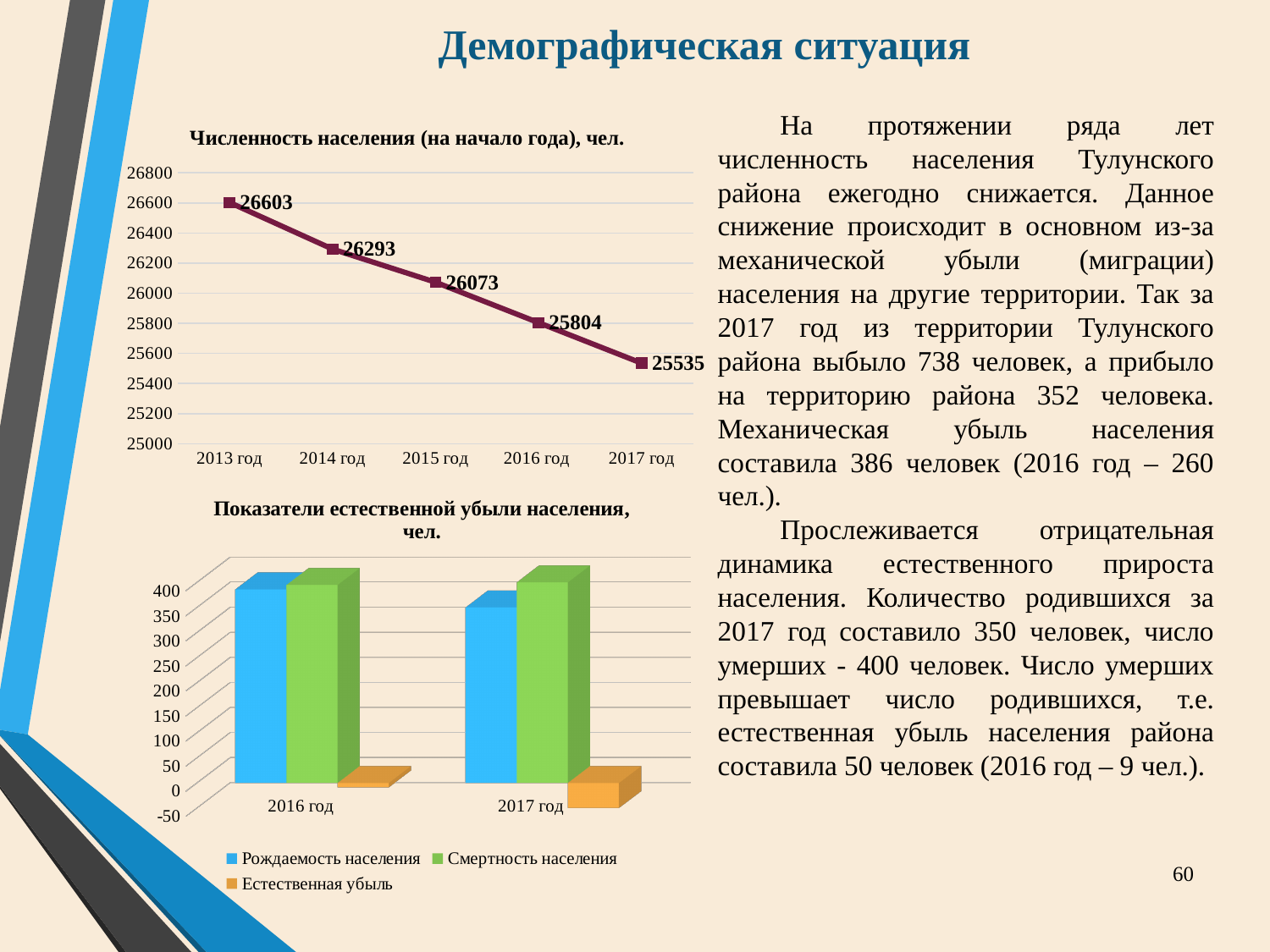
In the chart 'Численность населения (на начало года), чел.', what is the value for 2013 год? 26603 In the chart 'Показатели естественной убыли населения, чел.', how many series does the legend list? 3 In the chart 'Численность населения (на начало года), чел.', what is the difference between the values for 2013 год and 2017 год? 1068 In the chart 'Показатели естественной убыли населения, чел.', is the value for Рождаемость населения in 2017 год greater or less than 400? less In the chart 'Численность населения (на начало года), чел.', what is the value for 2015 год? 26073 In the chart 'Численность населения (на начало года), чел.', what is the value for 2017 год? 25535 In the chart 'Численность населения (на начало года), чел.', which year has the lowest value? 2017 год In the chart 'Численность населения (на начало года), чел.', do the values rise or fall from 2013 год to 2017 год? fall What kind of chart is 'Показатели естественной убыли населения, чел.'? bar chart In the chart 'Численность населения (на начало года), чел.', which year has the highest value? 2013 год In the chart 'Численность населения (на начало года), чел.', how many years are plotted? 5 In the chart 'Численность населения (на начало года), чел.', what is the difference between the values for 2016 год and 2017 год? 269